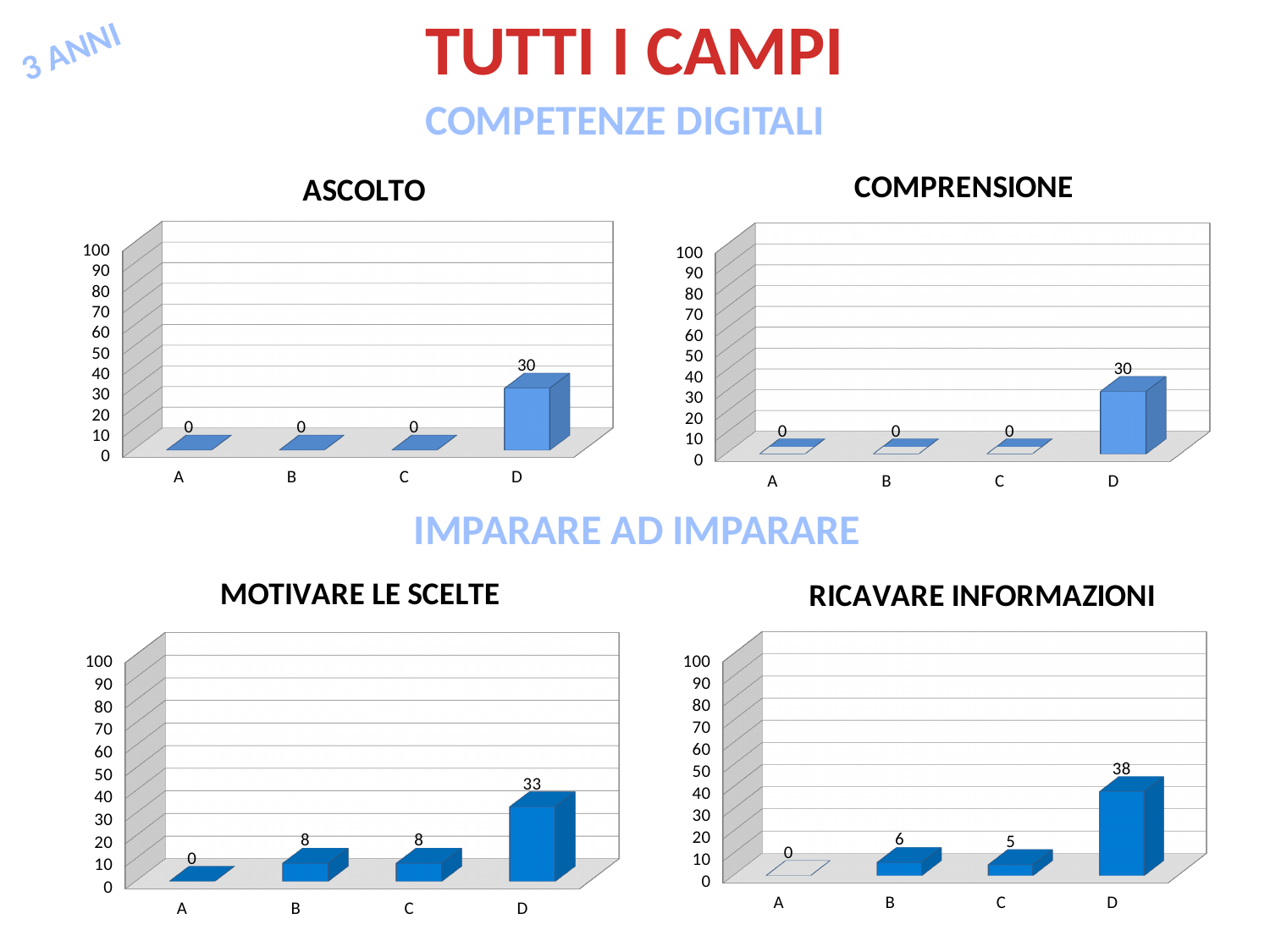
In the RICAVARE INFORMAZIONI chart, which is larger, the value for B or the value for C? B In the ASCOLTO chart, what is the value for D? 30 In the RICAVARE INFORMAZIONI chart, what is the difference between the values for D and B? 32 In the MOTIVARE LE SCELTE chart, what is the difference between the values for D and C? 25 In the MOTIVARE LE SCELTE chart, what is the value for B? 8 In the MOTIVARE LE SCELTE chart, which category has the lowest value? A How many charts are shown on the slide? 4 In the RICAVARE INFORMAZIONI chart, which category has the highest value? D In the RICAVARE INFORMAZIONI chart, what is the value for C? 5 What kind of chart is the COMPRENSIONE chart? bar chart In the COMPRENSIONE chart, what is the value for A? 0 How many categories are shown in the ASCOLTO chart? 4